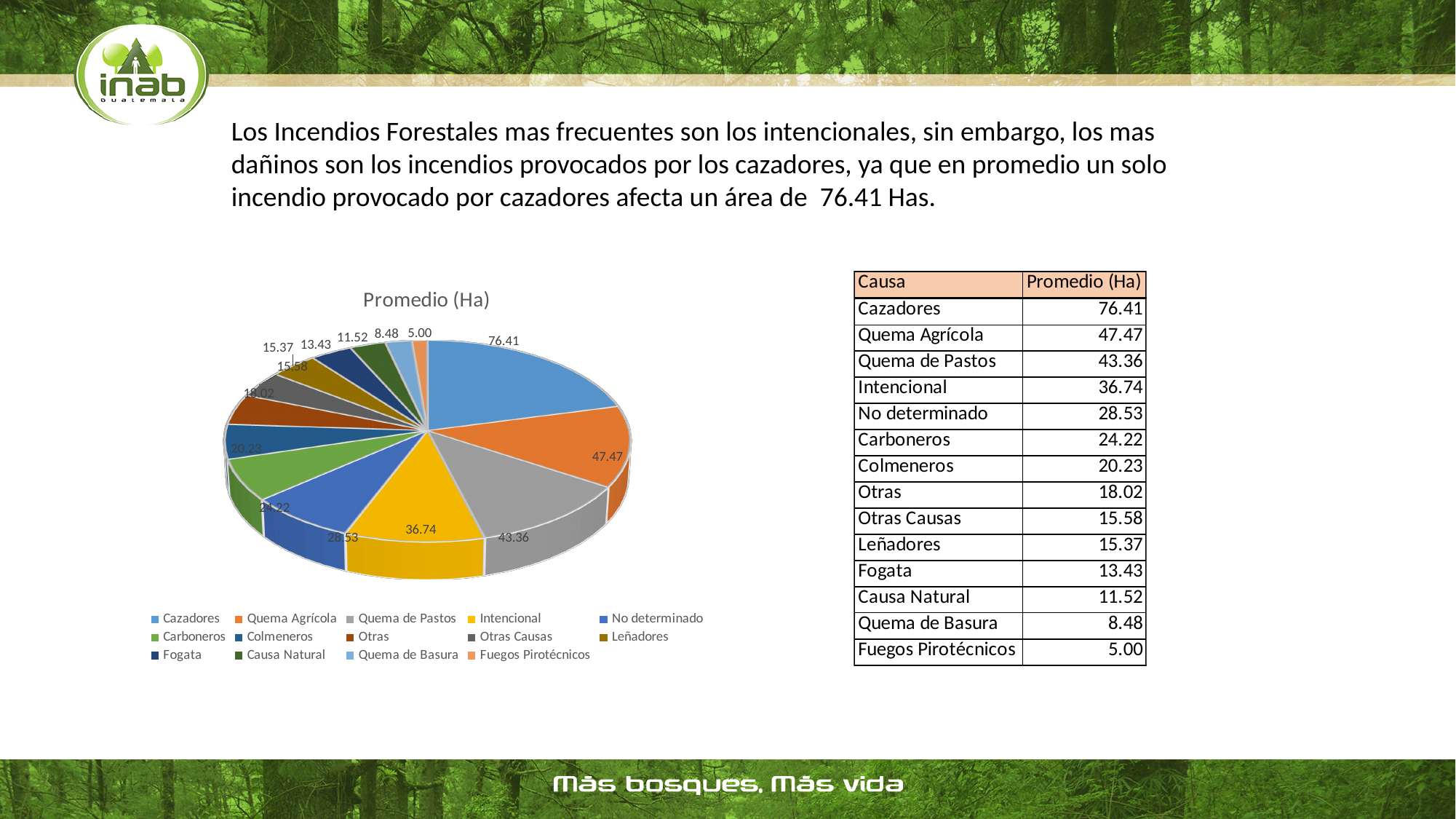
Which category has the smallest slice in the pie chart? Fuegos Pirotécnicos How many categories does the pie chart have? 14 Which legend entry is shown in yellow in the pie chart? Intencional What is the difference between the values for Cazadores and Quema Agrícola? 28.94 What is the value for Quema de Pastos in the pie chart? 43.36 What kind of chart is shown on the slide? Pie chart Which category has the largest slice in the pie chart? Cazadores What is the title of the chart? Promedio (Ha) What is the value for Quema de Basura in the pie chart? 8.48 What is the value for Fogata in the pie chart? 13.43 What is the value for Cazadores in the pie chart? 76.41 Which is larger, the value for Carboneros or the value for Colmeneros? Carboneros